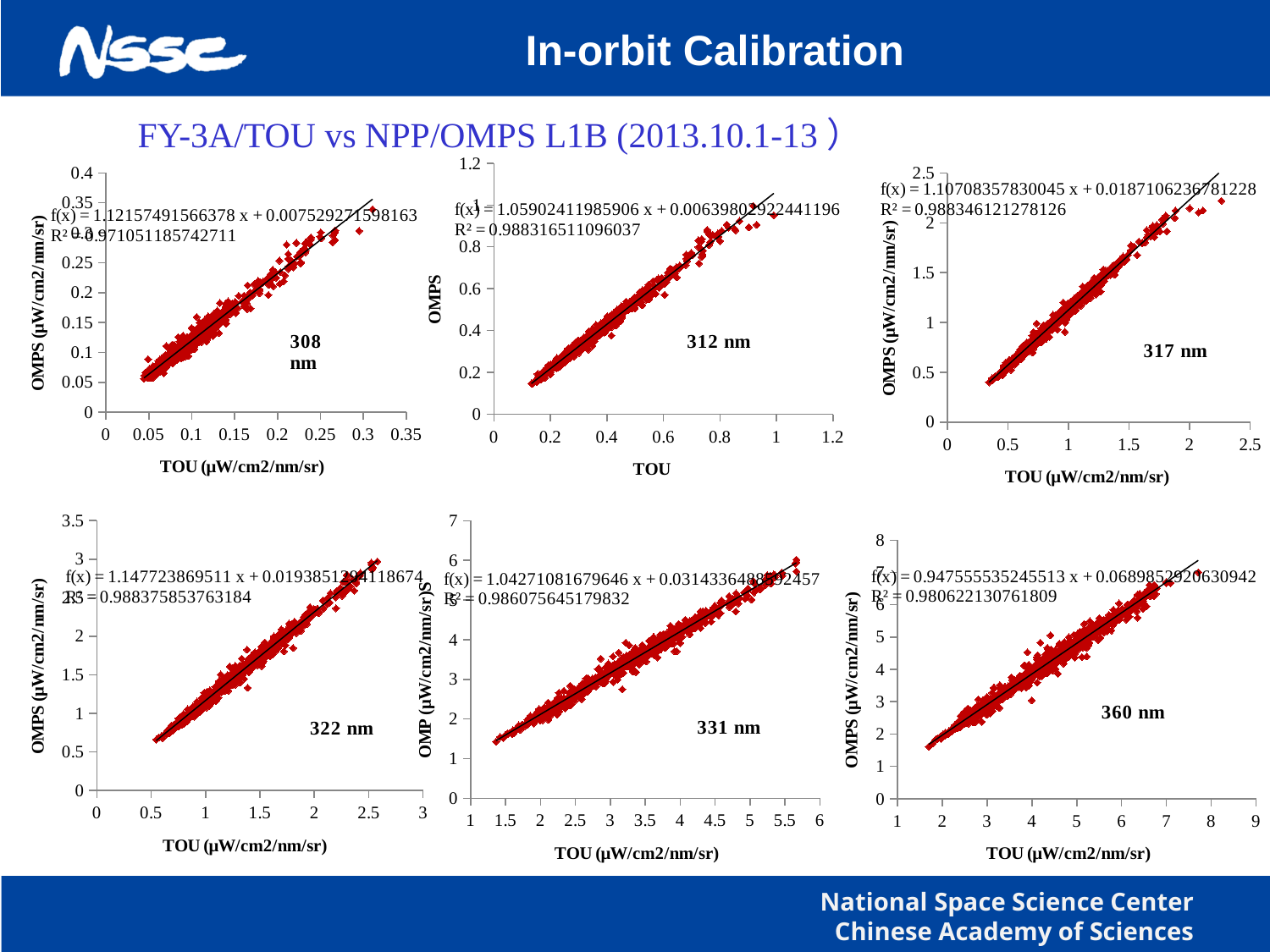
What is the slope of the fitted line in the 331 nm chart? 1.04271081679646 How many charts are shown on the slide? 6 What is the slope of the fitted line in the 360 nm chart? 0.947555535245513 Which chart has the highest fitted-line slope? 322 nm What kind of chart is used in each of the six panels on the slide? Scatter plot Which wavelengths are labelled on the six charts? 308 nm, 312 nm, 317 nm, 322 nm, 331 nm, 360 nm Is the fitted-line slope larger in the 308 nm chart or the 312 nm chart? 308 nm What is the R² value printed on the 360 nm chart? 0.980622130761809 What is the R² value printed on the 308 nm chart? 0.971051185742711 In the 308 nm chart, do the OMPS values rise or fall as TOU increases? Rise Which chart has the lowest printed R² value? 308 nm In the 360 nm chart, are the highest OMPS values greater or less than 8? less